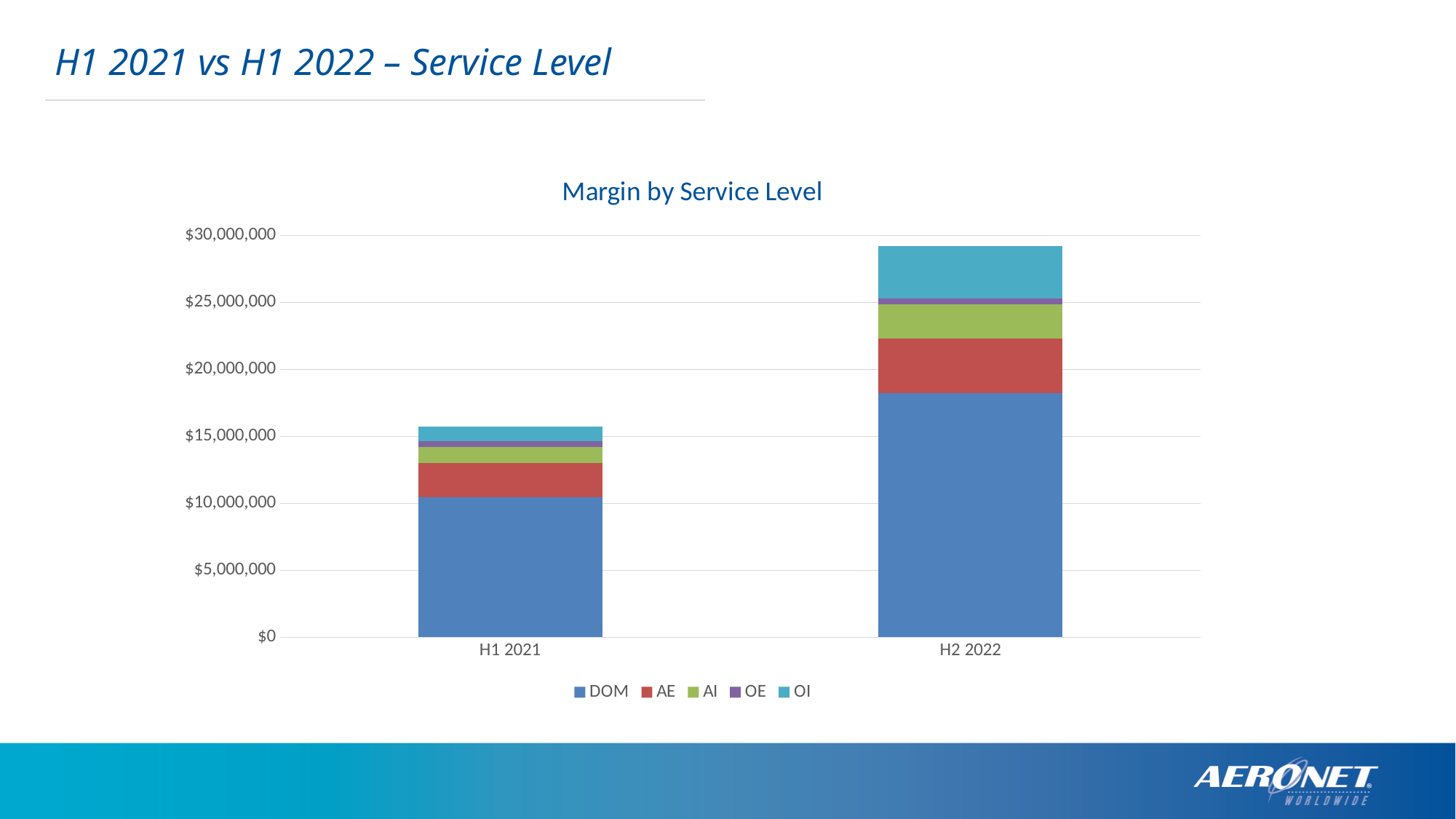
Which category has the taller stacked bar? H2 2022 What kind of chart is shown on the slide? Stacked bar chart Does the total margin rise or fall from H1 2021 to H2 2022? rise Is the DOM segment for H2 2022 greater or less than $15,000,000? greater Is the total stacked bar for H2 2022 greater or less than $30,000,000? less Is the total stacked bar for H2 2022 greater or less than $25,000,000? greater How many series does the legend list? 5 Which series are listed in the legend? DOM, AE, AI, OE, OI How many categories are shown on the x axis? 2 What is the title of the chart? Margin by Service Level Which category has the shorter stacked bar? H1 2021